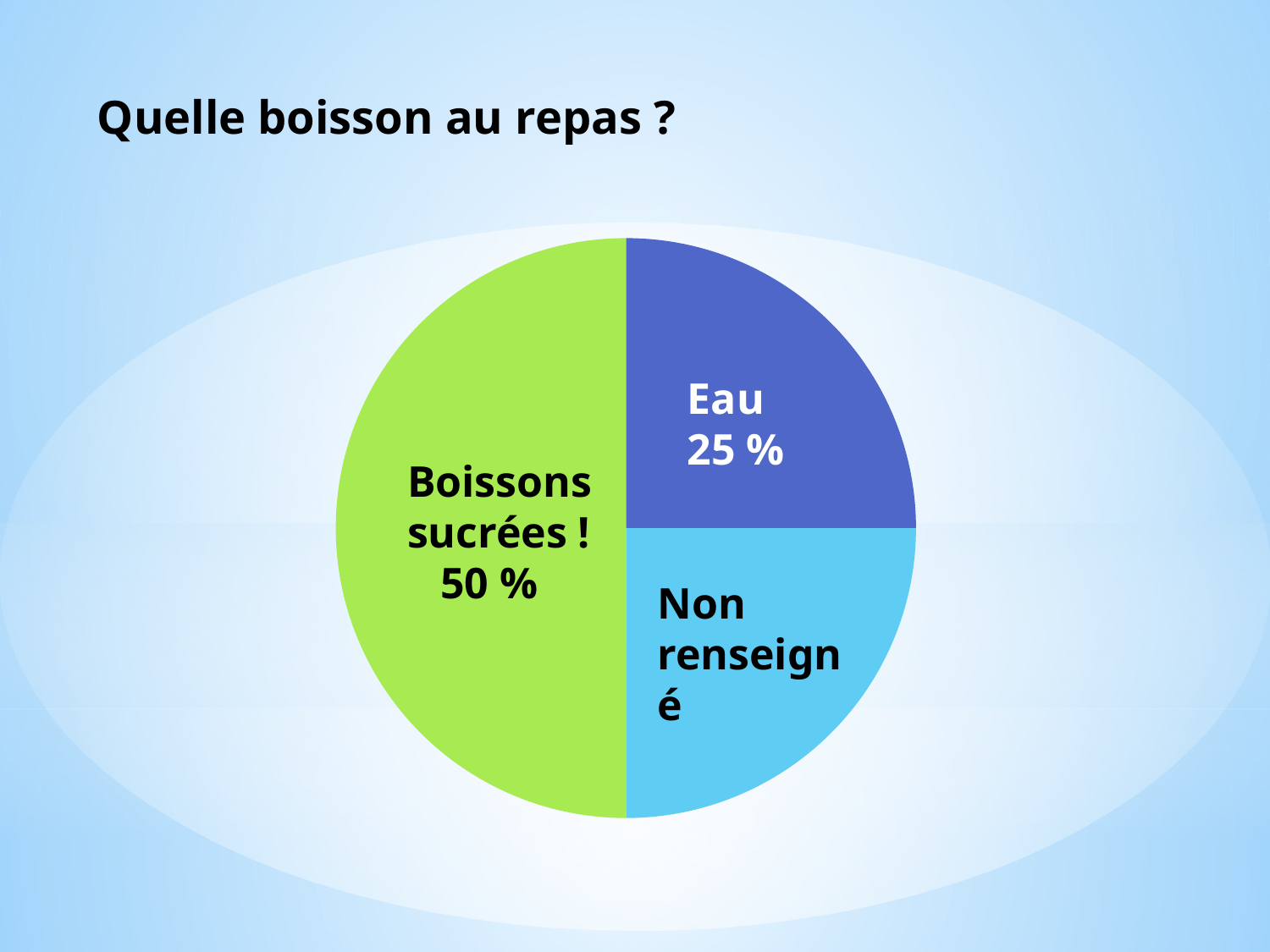
What kind of chart is shown on the slide? Pie chart What is the difference between the "Boissons sucrées !" percentage and the "Eau" percentage? 25 % How many slices does the pie chart have? 3 What share of the pie does the "Boissons sucrées !" slice represent? 50 % What percentage is shown for the "Eau" slice? 25 % Which is larger, the "Boissons sucrées !" slice or the "Eau" slice? Boissons sucrées ! What percentage is shown for the "Boissons sucrées !" slice? 50 % Which slice of the pie chart is the largest? Boissons sucrées ! What colour is the "Boissons sucrées !" slice? Green What is the title of the chart on the slide? Quelle boisson au repas ? Which slice of the pie chart has no percentage printed on it? Non renseigné